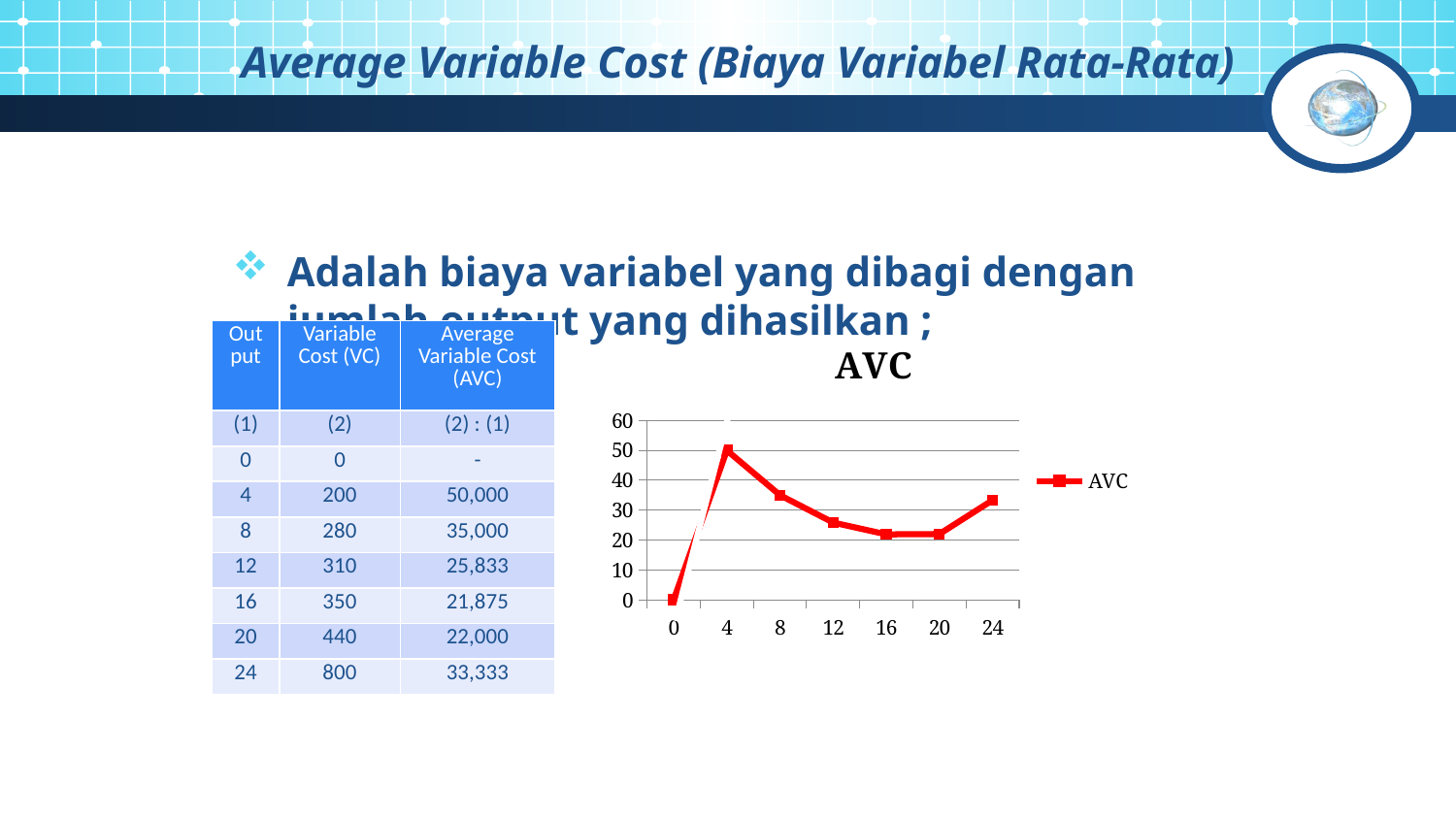
Is the AVC value at output 20 greater or less than 30? less What kind of chart is shown on the slide? line chart What is the AVC value plotted at output 4? 50 At which output level is the plotted AVC lowest? 0 How many series does the chart legend list? 1 What is the title of the chart? AVC At which output level is the plotted AVC highest? 4 Do the AVC values rise or fall as output increases from 4 to 16? fall Which has a higher plotted AVC value, output 4 or output 8? output 4 What is the AVC value plotted at output 0? 0 How many data points are plotted on the AVC line? 7 Is the AVC value at output 8 greater or less than 30? greater